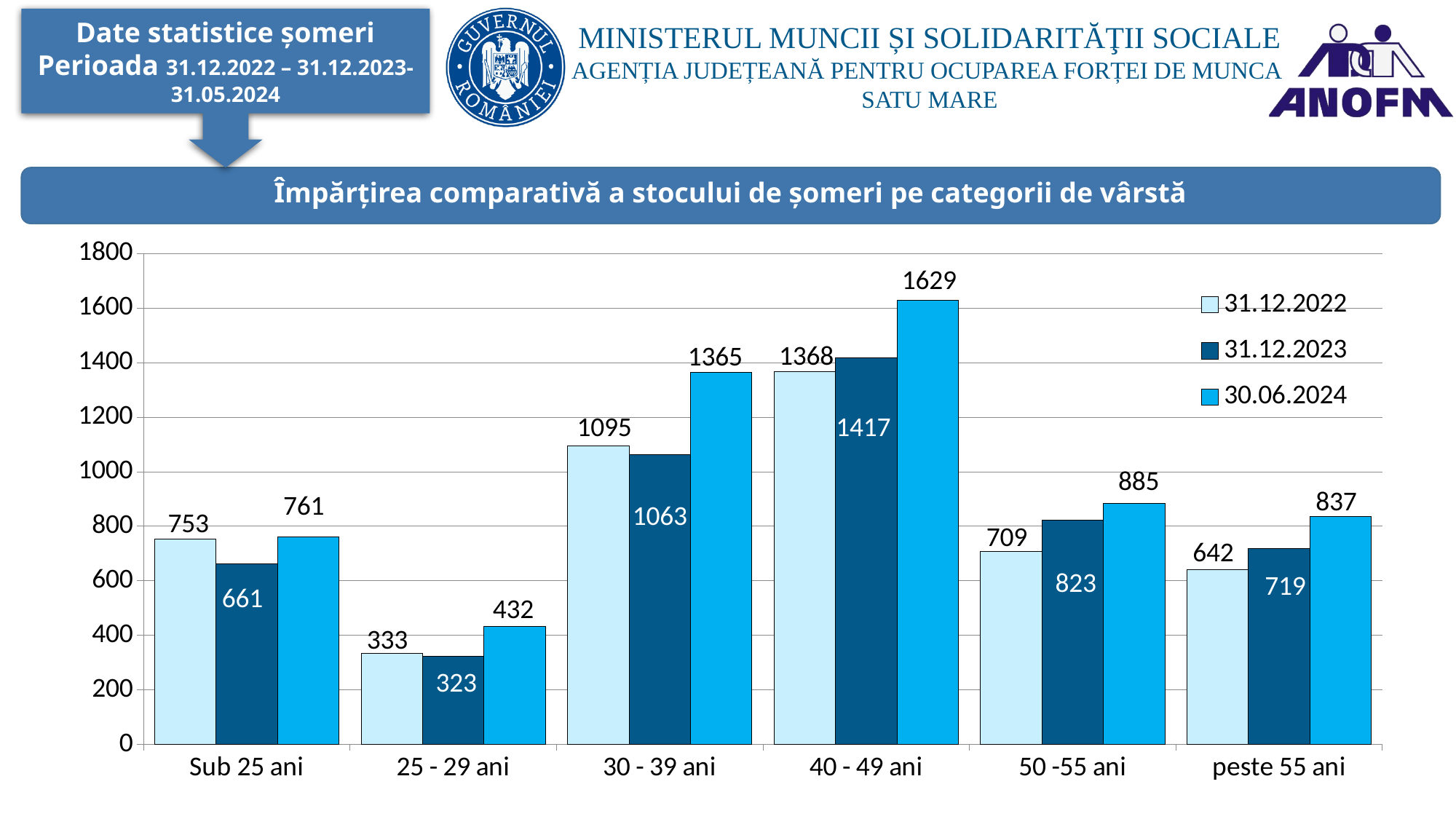
Which age category has the lowest value in the 30.06.2024 series? 25 - 29 ani What kind of chart is shown on the slide? bar chart What is the difference between the 30.06.2024 and 31.12.2022 values for 30 - 39 ani? 270 How many series does the legend list? 3 What is the value for 40 - 49 ani in the 30.06.2024 series? 1629 What is the value for peste 55 ani in the 31.12.2022 series? 642 What is the title of the chart? Împărțirea comparativă a stocului de șomeri pe categorii de vârstă Is the value for 50 -55 ani in the 31.12.2023 series greater or less than 800? greater Which is larger for Sub 25 ani: the 31.12.2022 value or the 30.06.2024 value? 30.06.2024 Which age category has the highest value in the 31.12.2022 series? 40 - 49 ani What is the value for 25 - 29 ani in the 31.12.2023 series? 323 How many age categories are shown on the x axis? 6